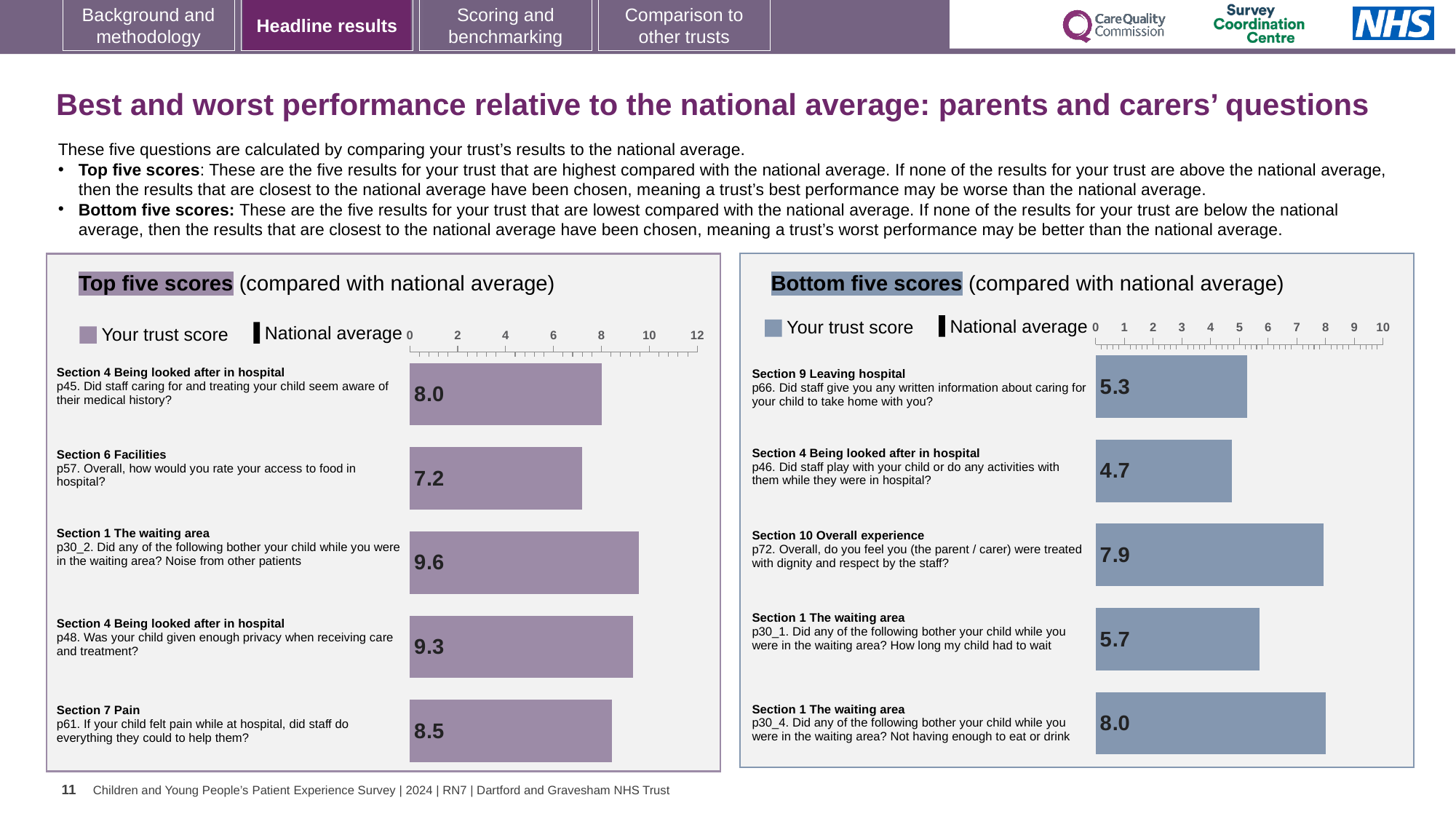
In the Bottom five scores chart, which has the larger trust score: p72 (dignity and respect) or p30_1 (how long my child had to wait)? p72 (dignity and respect) In the Top five scores chart, is the trust score for p61 (pain) greater or less than 8? greater In the Top five scores chart, what is the trust score for p57 (access to food in hospital)? 7.2 What type of chart is used in the Top five scores panel? Bar chart What is the maximum value shown on the x axis of the Top five scores chart? 12 How many questions are shown in the Bottom five scores chart? 5 In the Top five scores chart, what is the difference between the scores for p30_2 (9.6) and p57 (7.2)? 2.4 In the Bottom five scores chart, what is the trust score for p46 (staff playing with your child or doing activities)? 4.7 In the Bottom five scores chart, which question has the lowest trust score? p46. Did staff play with your child or do any activities with them while they were in hospital? In the Bottom five scores chart, what is the difference between the scores for p30_4 and p66? 2.7 In the Top five scores chart, which question has the highest trust score? p30_2. Noise from other patients in the waiting area In the Top five scores chart, what is the trust score for p48 (enough privacy when receiving care and treatment)? 9.3